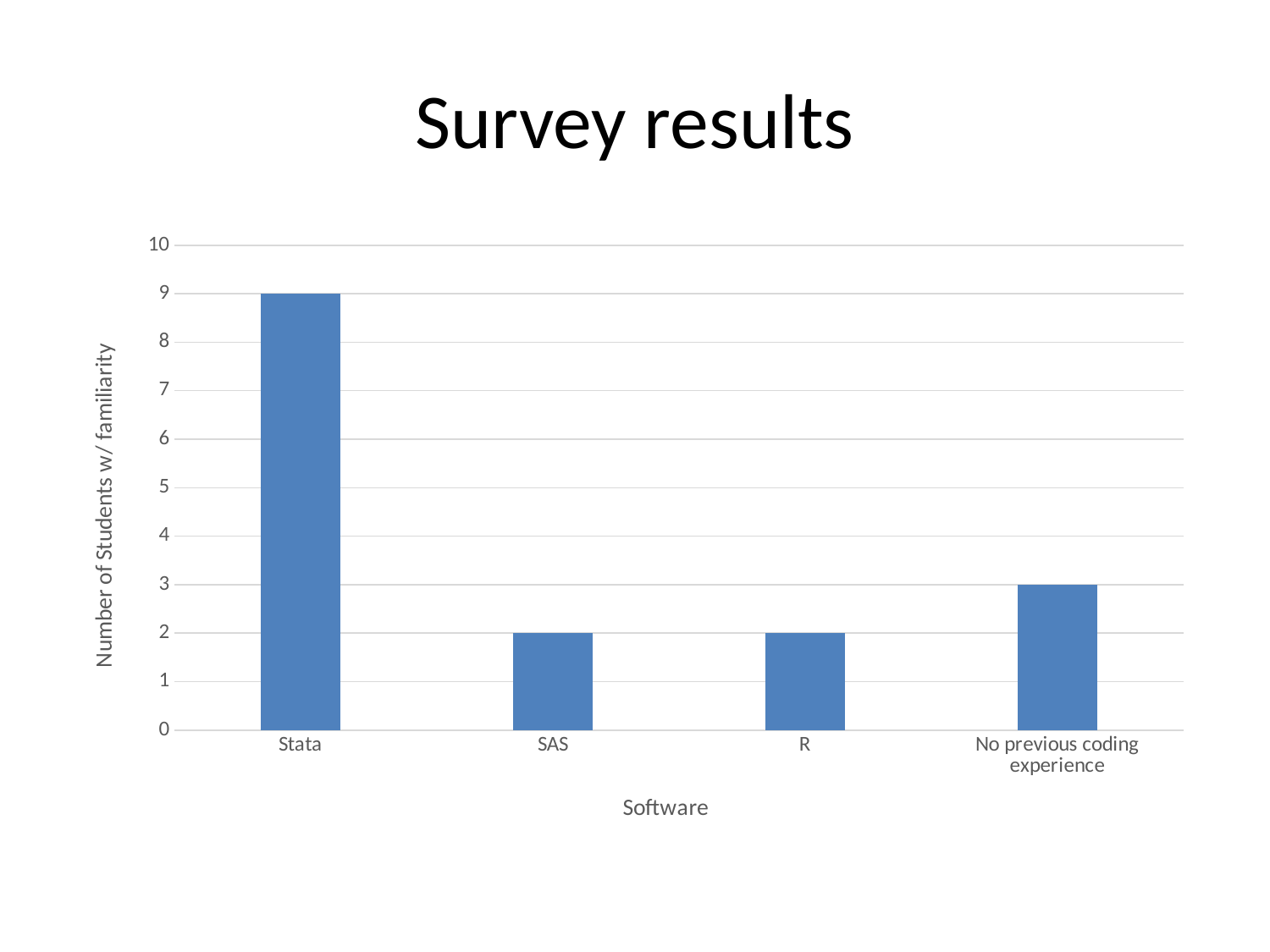
What is the title of the horizontal axis? Software What kind of chart is shown on the slide? Bar chart What is the title of the vertical axis? Number of Students w/ familiarity What is the difference between the number of students familiar with Stata and the number with no previous coding experience? 6 Which software has the highest number of students with familiarity? Stata What is the number of students with familiarity with R? 2 What is the number of students with familiarity with SAS? 2 What is the number of students with familiarity with Stata? 9 Which is larger: the number of students familiar with SAS or the number with no previous coding experience? No previous coding experience How many students reported no previous coding experience? 3 How many categories are shown on the x axis? 4 Is the value for Stata greater or less than 5? greater